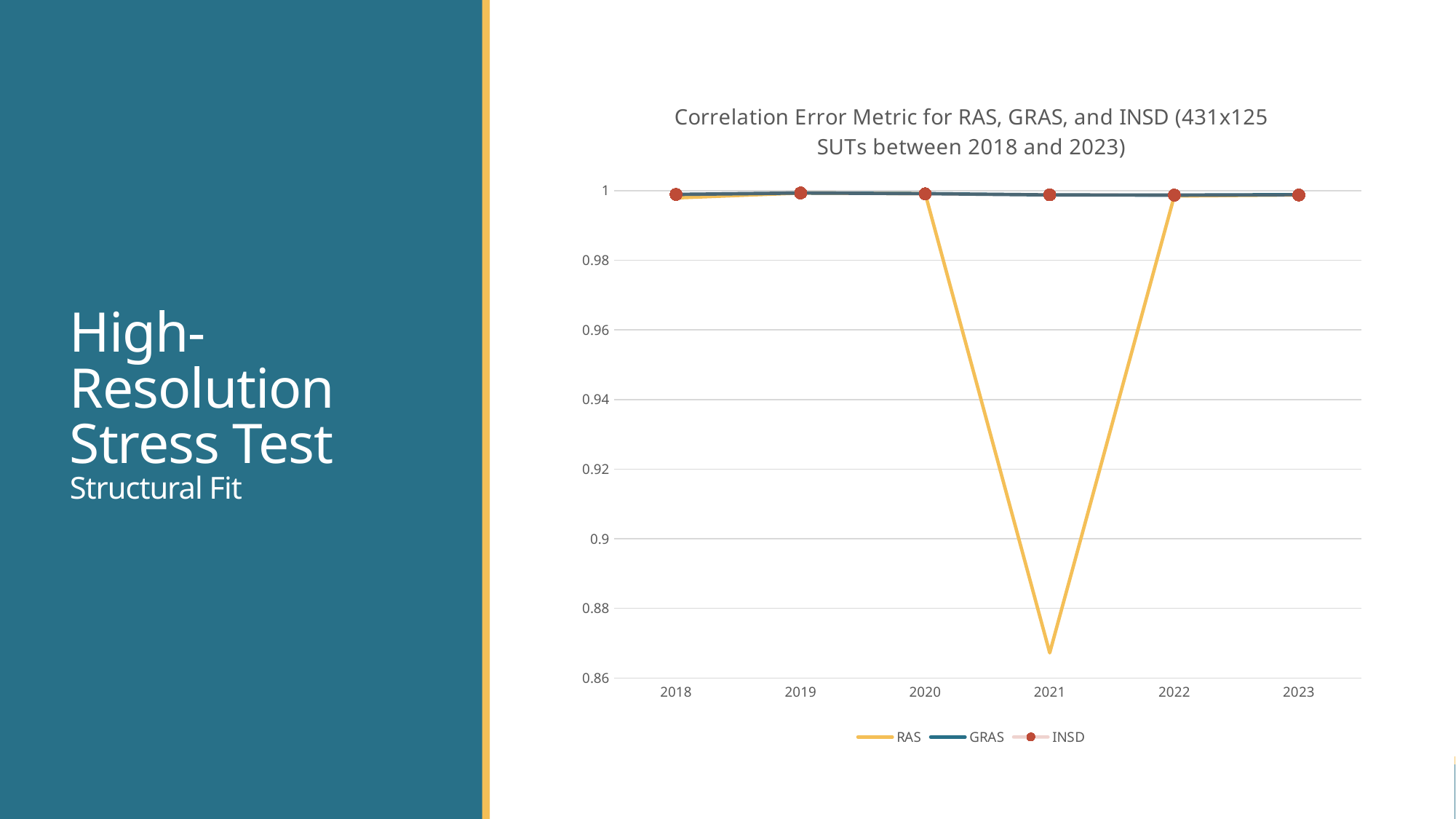
Which series is drawn in yellow? RAS Is the RAS value for 2021 greater or less than 0.86? greater Does the RAS series rise or fall between 2020 and 2021? fall Is the GRAS value for 2021 greater or less than 0.98? greater How many series does the legend list? 3 Which series has the larger value in 2021, RAS or GRAS? GRAS What kind of chart is shown on the slide? line chart In which year does the RAS series reach its lowest value? 2021 Is the RAS value for 2021 greater or less than 0.88? less Does the RAS series rise or fall between 2021 and 2022? rise How many years are plotted along the x axis? 6 What is the title of the chart? Correlation Error Metric for RAS, GRAS, and INSD (431x125 SUTs between 2018 and 2023)